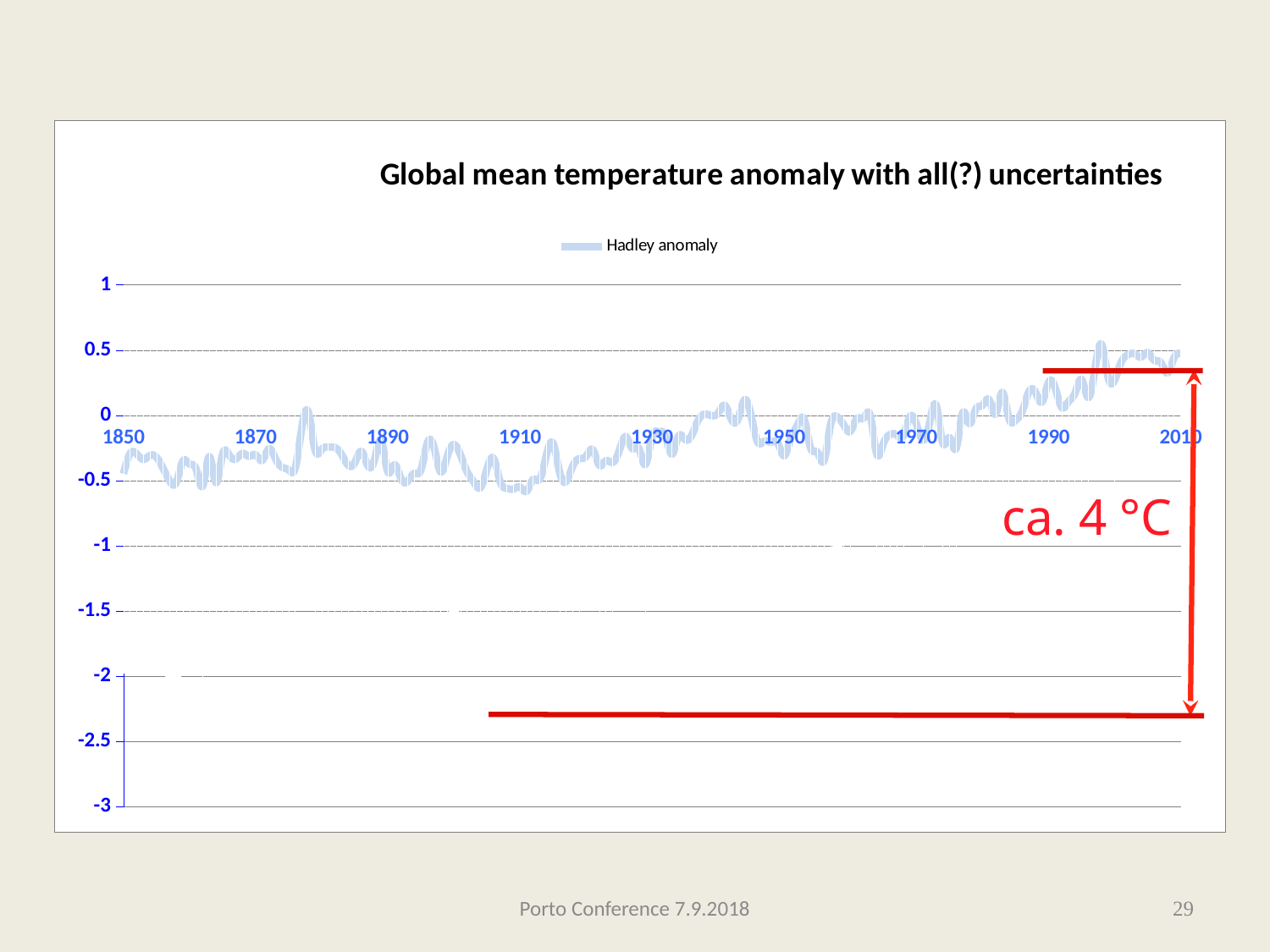
How many series does the legend list? 1 Is the value of the Hadley anomaly around 1910 greater or less than 0? less What is the lowest value labelled on the y axis? -3 Is the value of the Hadley anomaly around 2005 greater or less than 1? less Is the value of the Hadley anomaly around 2005 greater or less than 0? greater Overall, does the Hadley anomaly rise or fall from 1850 to 2010? rise What temperature difference is written in red on the chart? ca. 4 °C Does the Hadley anomaly reach its highest values before or after 1990? after What is the name of the series shown in the legend? Hadley anomaly What kind of chart is shown on the slide? line chart